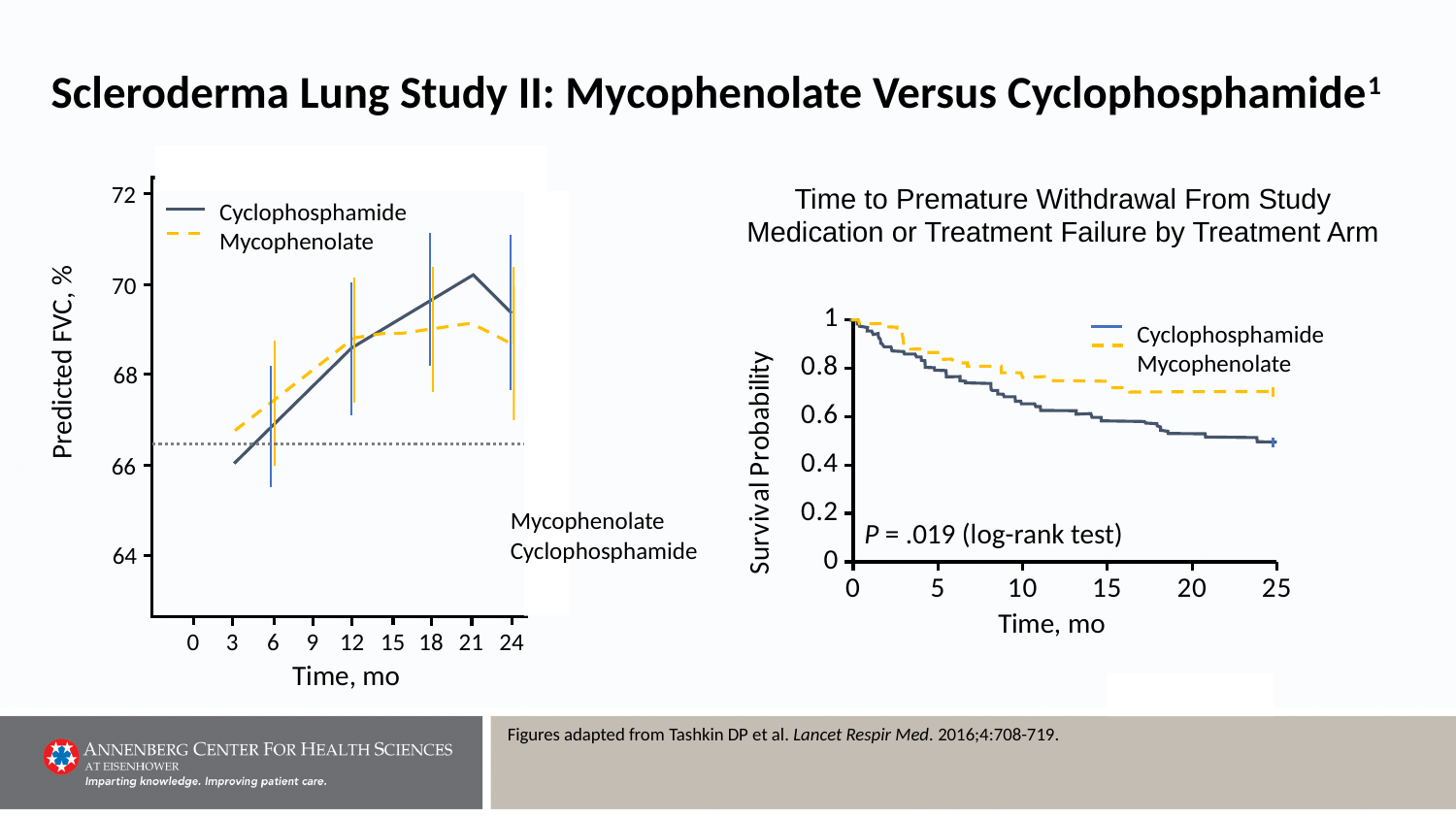
What is the title of the right chart? Time to Premature Withdrawal From Study Medication or Treatment Failure by Treatment Arm In the right chart (Time to Premature Withdrawal), is the Cyclophosphamide survival probability at 20 months greater or less than 0.6? less How many series does the legend of the left chart (Predicted FVC, %) list? 2 In the left chart (Predicted FVC, %), does the Cyclophosphamide line rise or fall between 3 and 21 months? rise In the left chart (Predicted FVC, %), is the Mycophenolate value at 24 months greater or less than 68? greater In the right chart (Time to Premature Withdrawal), is the Mycophenolate survival probability at 20 months greater or less than 0.6? greater What kind of chart is the left chart showing Predicted FVC, %? Line chart In the left chart (Predicted FVC, %), which series has the higher value at 21 months, Cyclophosphamide or Mycophenolate? Cyclophosphamide In the right chart (Time to Premature Withdrawal), do the survival curves rise or fall as time increases? fall What P value is printed on the right chart (Time to Premature Withdrawal)? P = .019 (log-rank test) In the right chart (Time to Premature Withdrawal), which treatment arm has the higher survival probability at 25 months? Mycophenolate